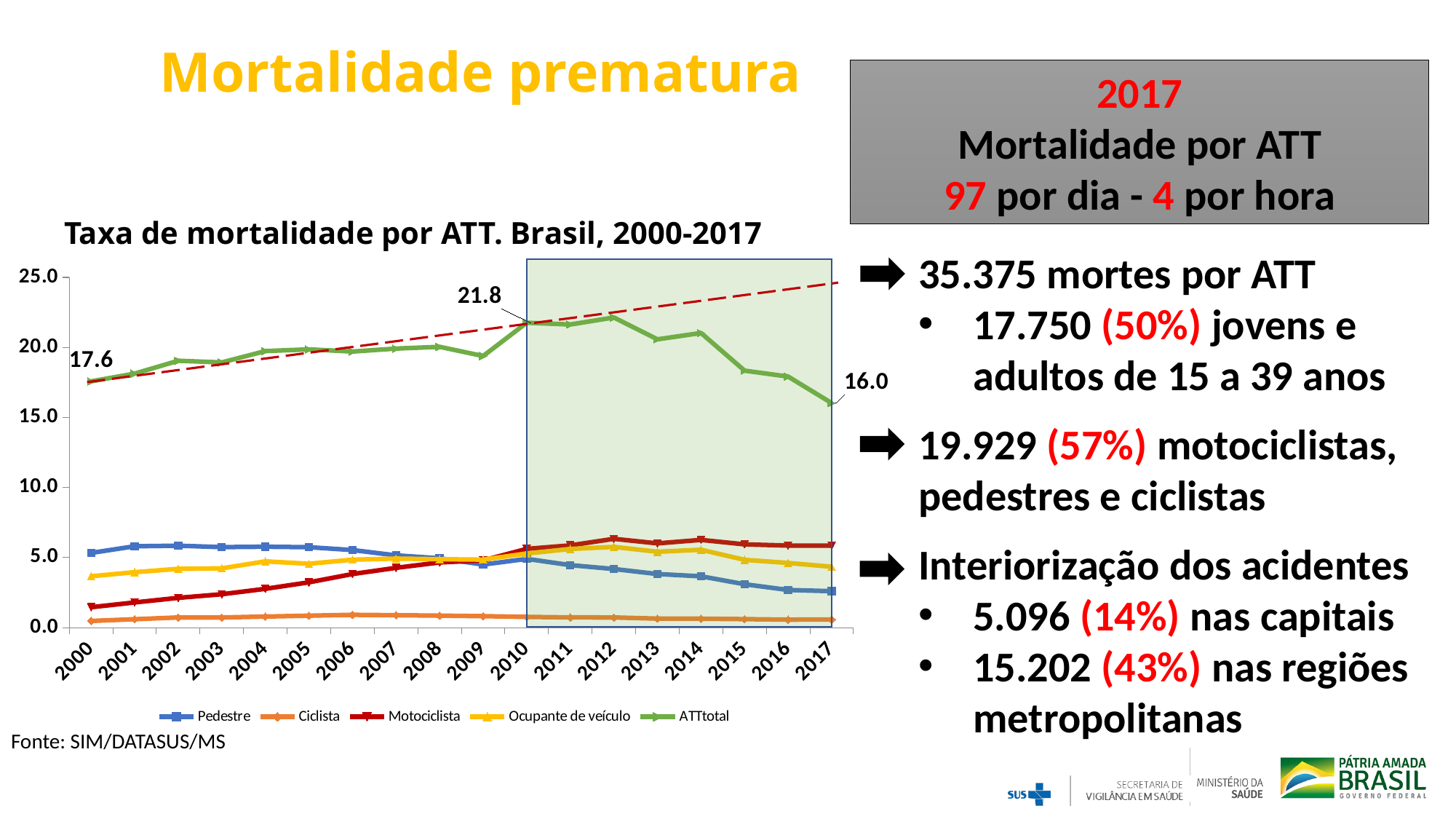
Is the Motociclista value for 2000 greater or less than 5.0? less Which series has the lowest value in 2017? Ciclista In 2017, which is higher: Motociclista or Pedestre? Motociclista What is the ATTtotal value for 2000? 17.6 Does the ATTtotal line rise or fall from 2012 to 2017? fall How many series does the chart legend list? 5 By how much did the ATTtotal value increase from 2000 to 2010? 4.2 What is the ATTtotal value for 2010? 21.8 What kind of chart is shown on the slide? line chart What is the ATTtotal value for 2017? 16.0 How many years are plotted on the x axis? 18 What is the difference between the ATTtotal values for 2010 and 2017? 5.8